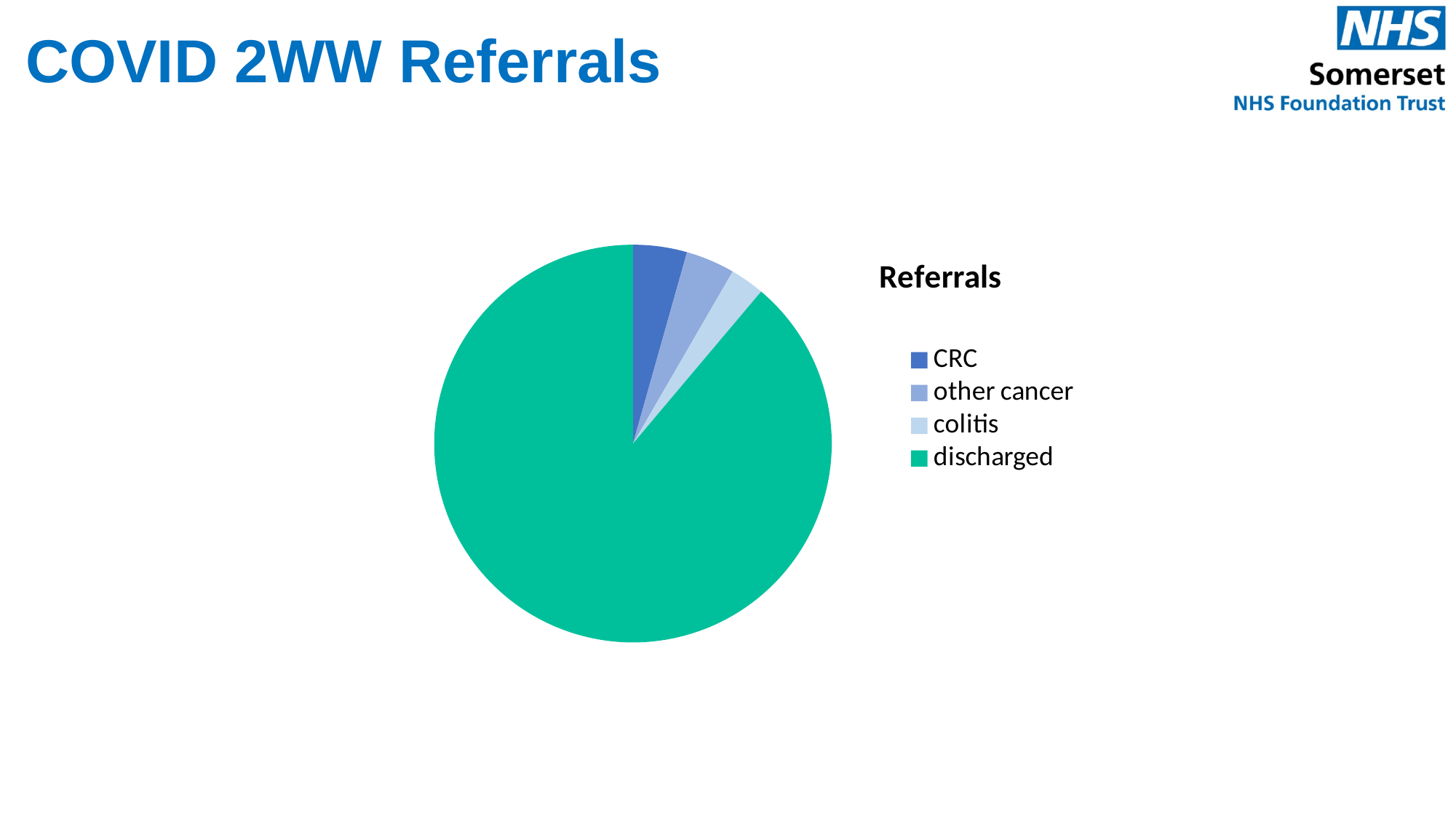
Which is larger, the slice for colitis or the slice for discharged? discharged Which legend entry is shown in green? discharged Does the discharged slice account for more or less than half of the pie? more Which is larger, the slice for discharged or the slice for CRC? discharged Which category is listed first in the legend? CRC What kind of chart is shown on the slide? pie chart Which category has the largest slice of the pie? discharged What is the title of the chart? Referrals How many categories does the pie chart's legend list? 4